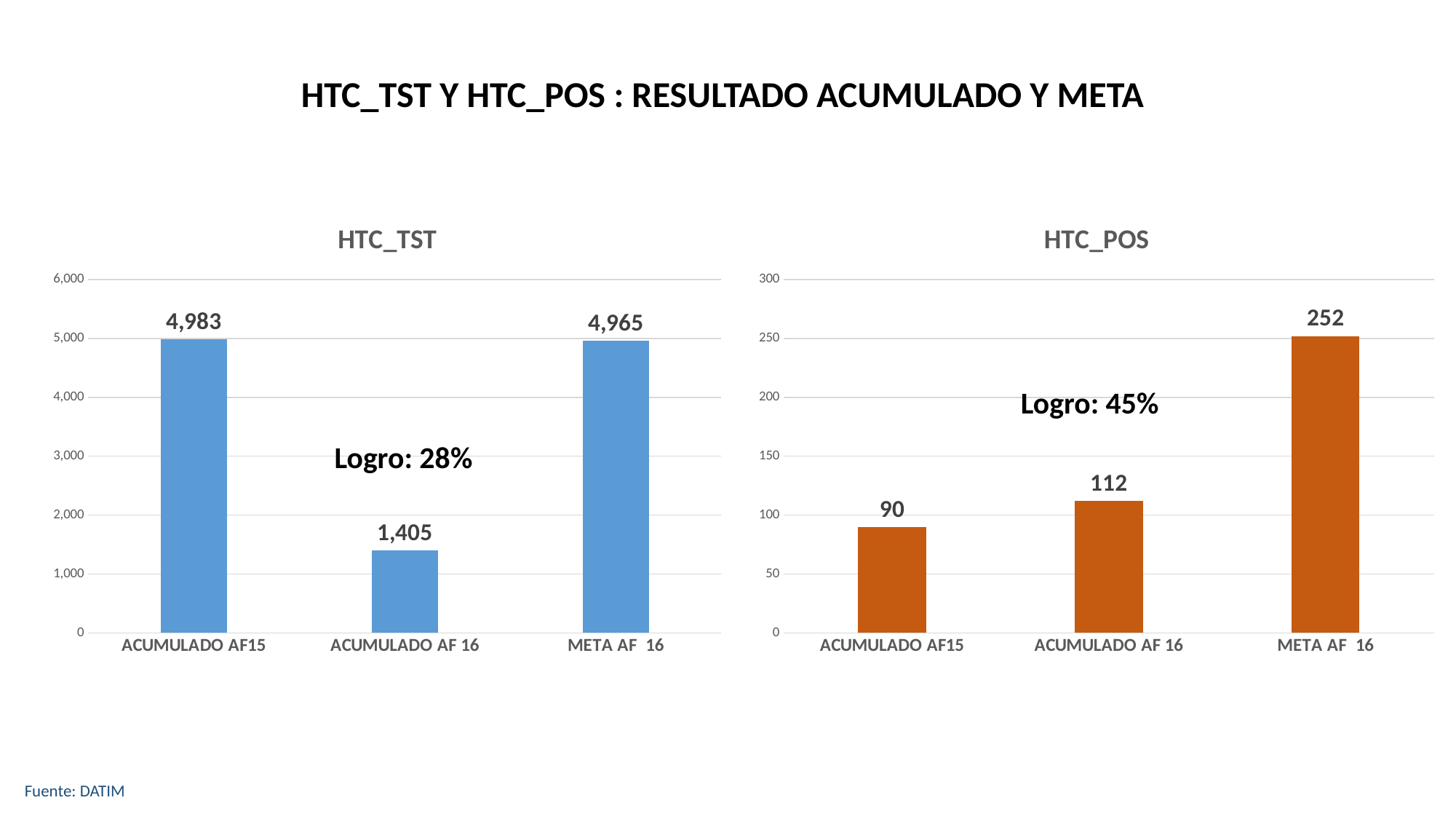
In the HTC_POS chart, which category has the highest value? META AF 16 In the HTC_TST chart, what is the value for ACUMULADO AF 16? 1,405 In the HTC_TST chart, what is the value for ACUMULADO AF15? 4,983 In the HTC_POS chart, what is the difference between ACUMULADO AF 16 and ACUMULADO AF15? 22 What is the Logro percentage shown on the HTC_POS chart? 45% In the HTC_POS chart, which is larger, ACUMULADO AF 16 or META AF 16? META AF 16 What type of chart is the HTC_POS chart? Bar chart In the HTC_POS chart, what is the value for ACUMULADO AF15? 90 In the HTC_TST chart, which category has the lowest value? ACUMULADO AF 16 In the HTC_TST chart, what is the difference between META AF 16 and ACUMULADO AF 16? 3,560 How many bars are in the HTC_TST chart? 3 In the HTC_POS chart, what is the value for META AF 16? 252